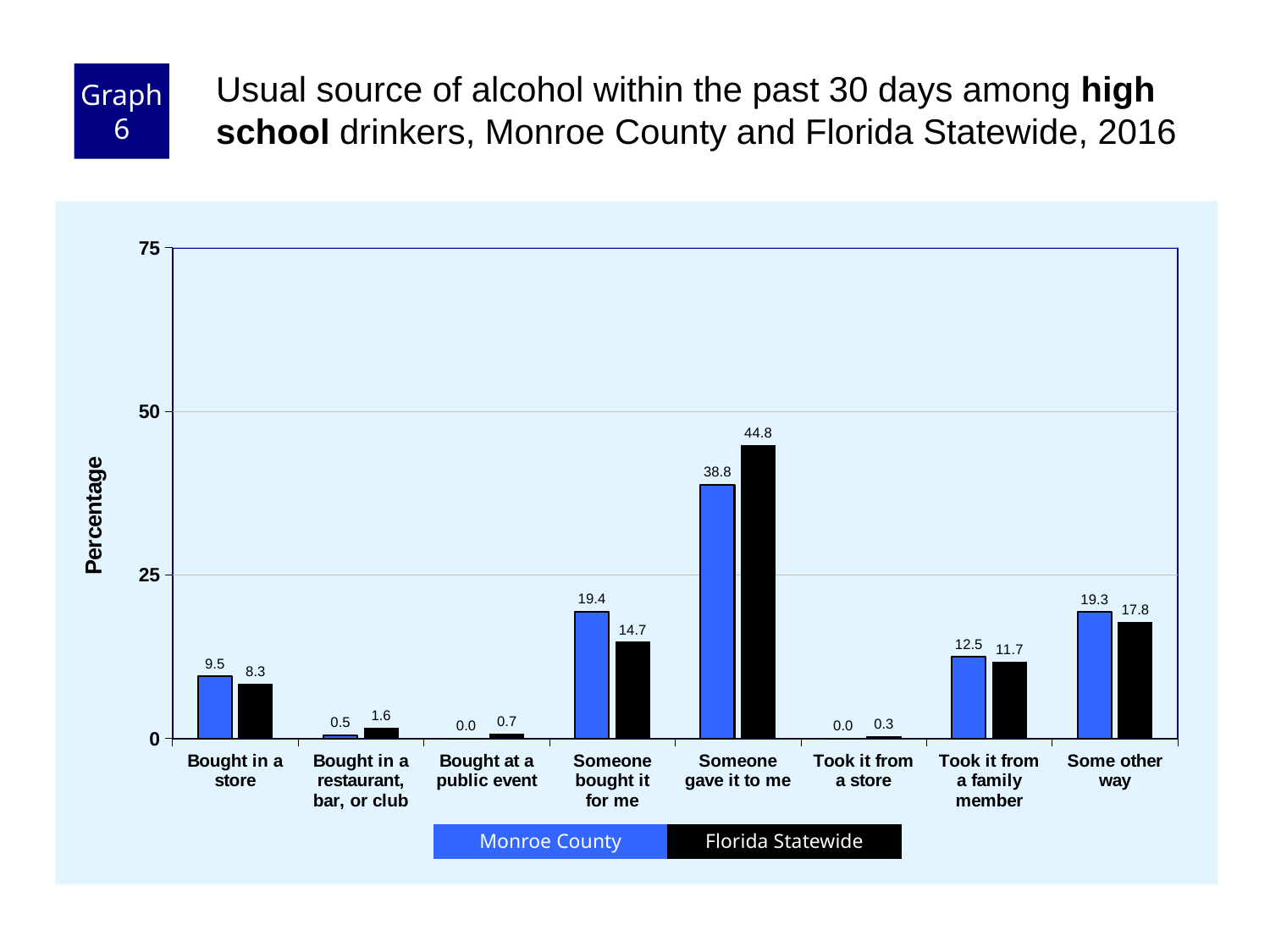
What colour represents Florida Statewide in the chart? black Which category has the highest Florida Statewide value? Someone gave it to me What is the Monroe County value for "Someone gave it to me"? 38.8 What kind of chart is shown on the slide? bar chart What is the Florida Statewide value for "Someone bought it for me"? 14.7 Which category has the lowest Florida Statewide value? Took it from a store How many source categories are shown on the x axis? 8 Is the Florida Statewide value for "Someone gave it to me" greater or less than 50? less How many series does the legend list? 2 Which is larger for "Bought in a store": Monroe County or Florida Statewide? Monroe County What is the Monroe County value for "Took it from a family member"? 12.5 What is the difference between the Florida Statewide and Monroe County values for "Someone gave it to me"? 6.0